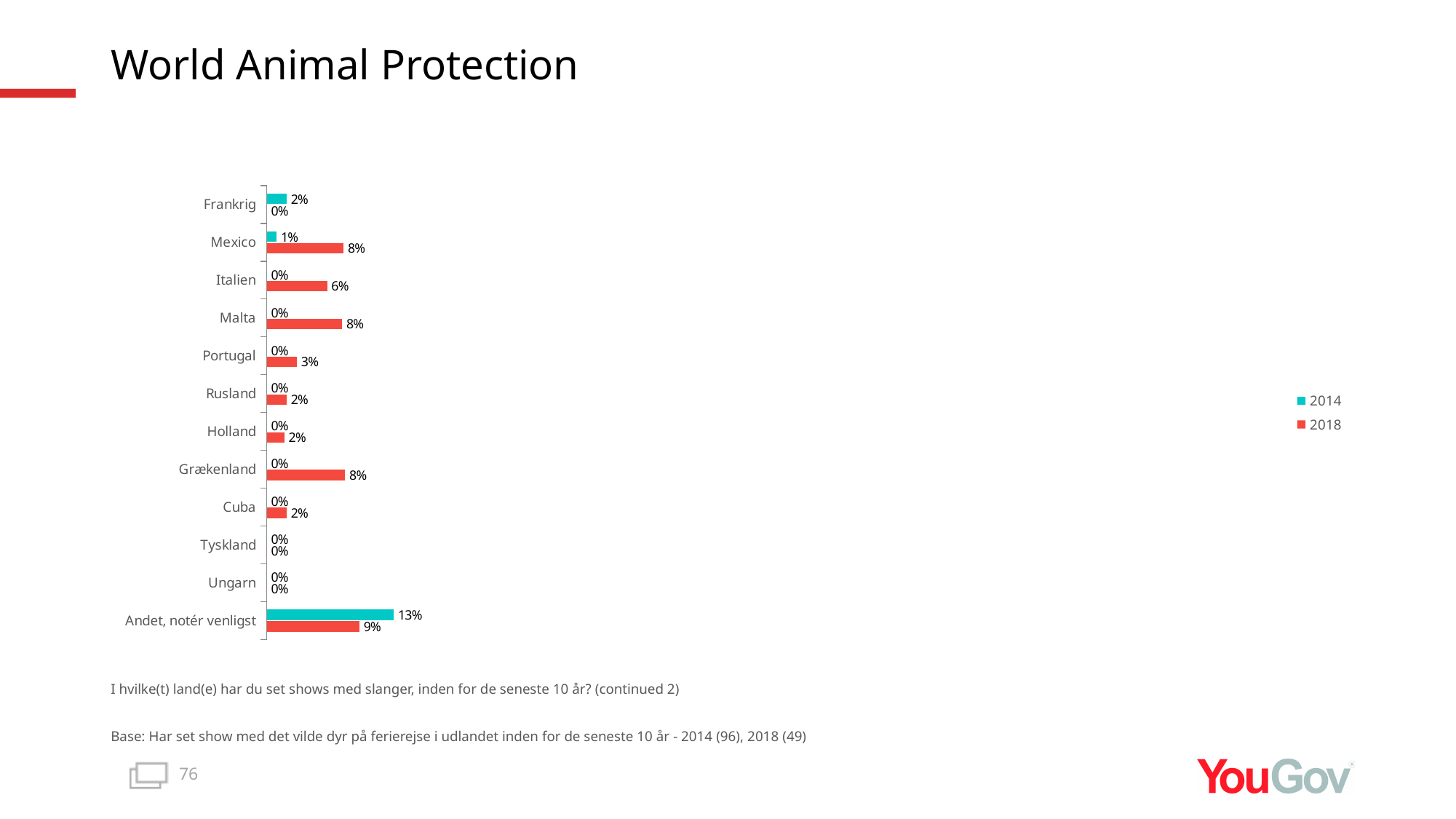
Which category has the highest 2018 value? Andet, notér venligst What is the difference between the 2018 values for Malta and Portugal? 5% How many series does the legend list? 2 What is the 2018 value for Italien? 6% Which category has the highest 2014 value? Andet, notér venligst What is the 2014 value for Frankrig? 2% What is the 2018 value for Mexico? 8% What is the difference between the 2014 and 2018 values for Andet, notér venligst? 4% Which is larger, the 2018 value for Grækenland or the 2018 value for Cuba? Grækenland How many categories are shown on the chart? 12 What is the 2018 value for Portugal? 3% What kind of chart is shown on the slide? Bar chart